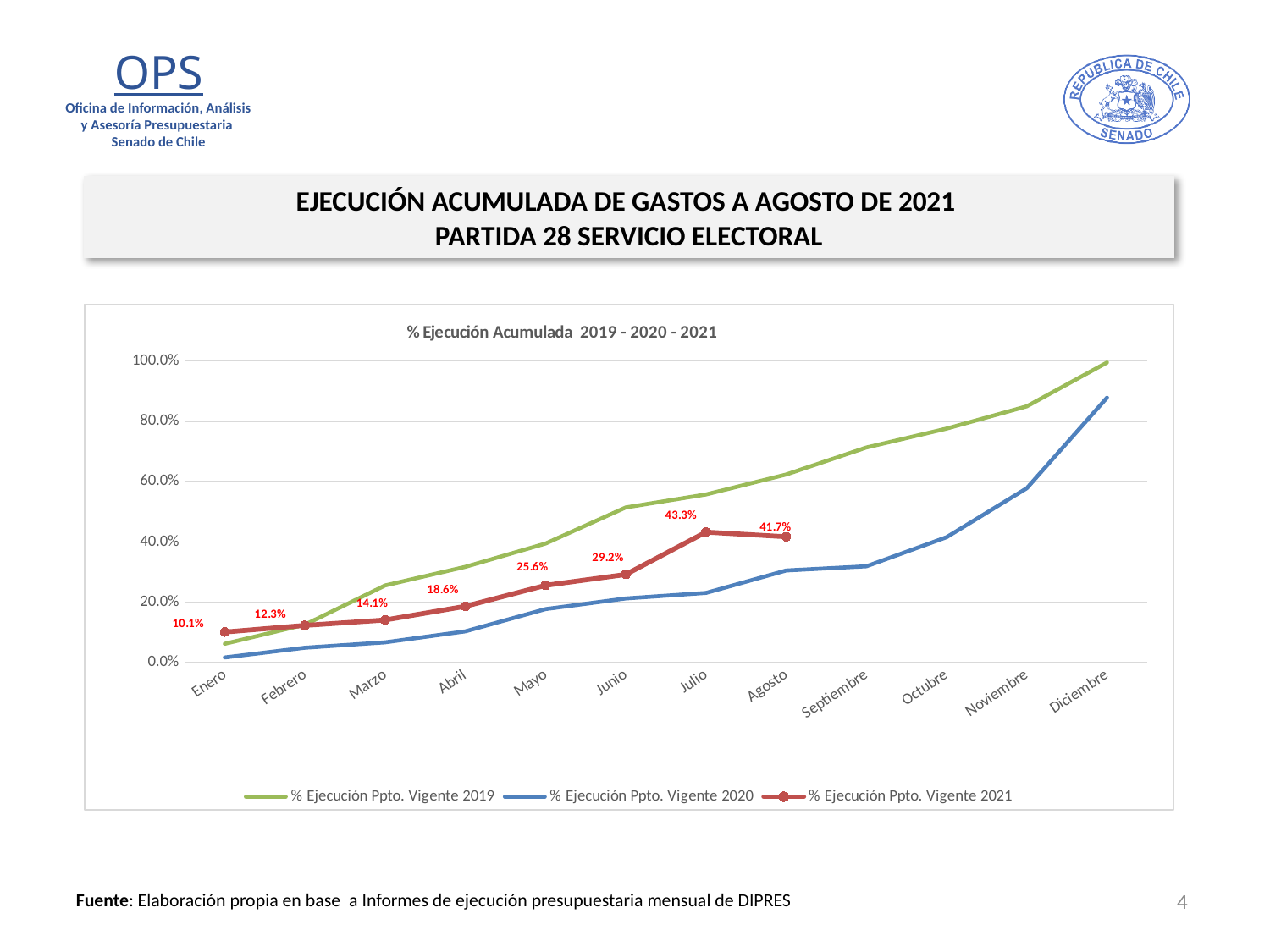
What is the value of % Ejecución Ppto. Vigente 2021 for Abril? 18.6% What is the difference between the % Ejecución Ppto. Vigente 2021 values for Julio and Junio? 14.1% Is the value of % Ejecución Ppto. Vigente 2019 for Diciembre greater or less than 80.0%? greater In which month does the % Ejecución Ppto. Vigente 2021 series reach its highest labelled value? Julio What is the value of % Ejecución Ppto. Vigente 2021 for Enero? 10.1% How many series does the legend list? 3 In which month is the % Ejecución Ppto. Vigente 2021 series lowest? Enero What kind of chart is shown on the slide? Line chart What is the value of % Ejecución Ppto. Vigente 2021 for Agosto? 41.7% What is the value of % Ejecución Ppto. Vigente 2021 for Julio? 43.3% Which is larger for % Ejecución Ppto. Vigente 2021: the value for Mayo or the value for Marzo? Mayo What is the title of the chart? % Ejecución Acumulada 2019 - 2020 - 2021